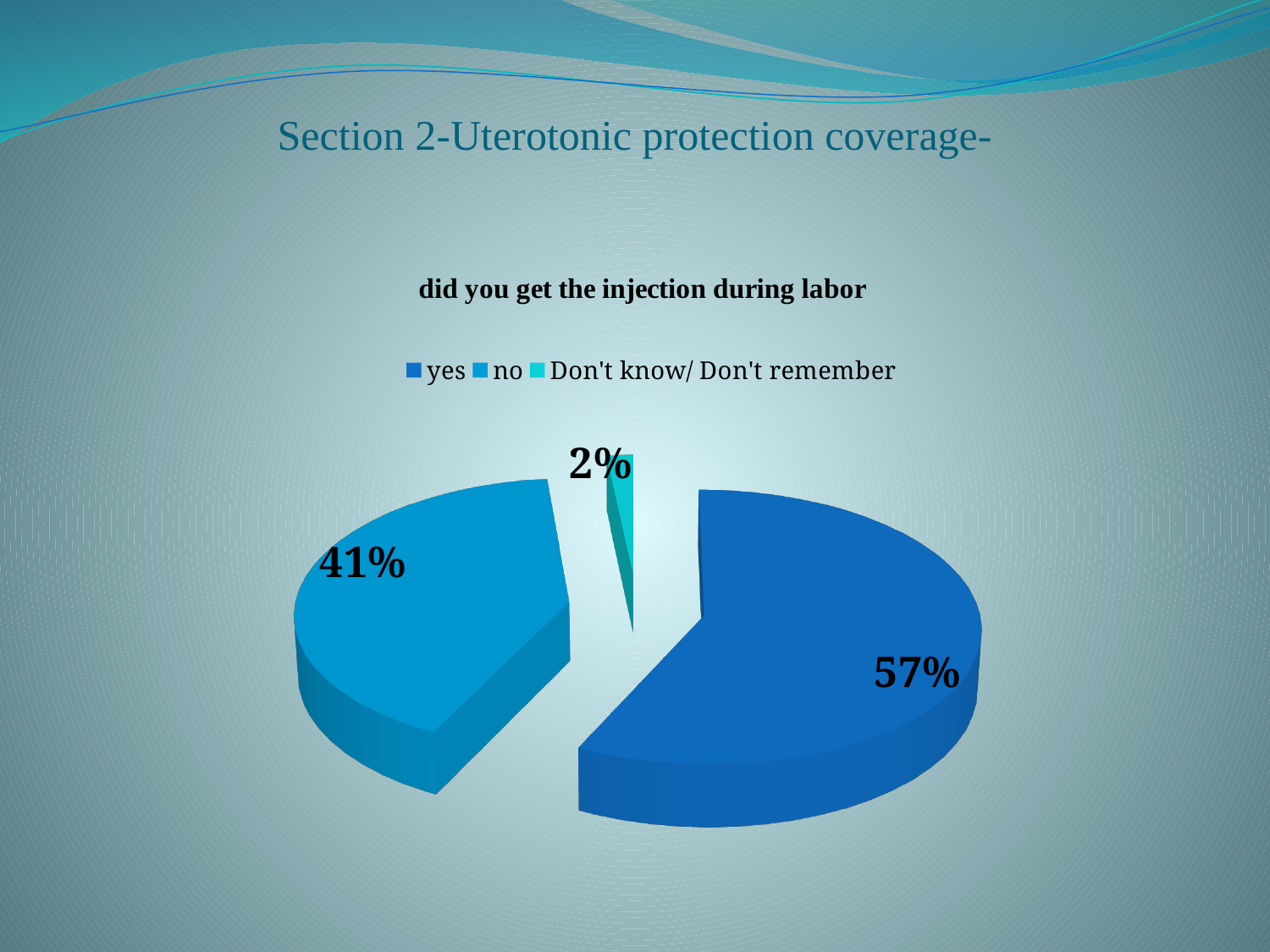
What is the difference in percentage points between the "yes" and "no" slices? 16 What percentage of respondents answered "no"? 41% Which response has the smallest share of the pie? Don't know/ Don't remember Which is larger, the "no" slice or the "Don't know/ Don't remember" slice? no What type of chart is shown on the slide? pie chart How many slices does the pie chart have? 3 How many entries does the legend list? 3 Which response has the largest share of the pie? yes What percentage of respondents answered "Don't know/ Don't remember"? 2% What is the chart's title? did you get the injection during labor What is the combined share of the "no" and "Don't know/ Don't remember" slices? 43% What percentage of respondents answered "yes"? 57%